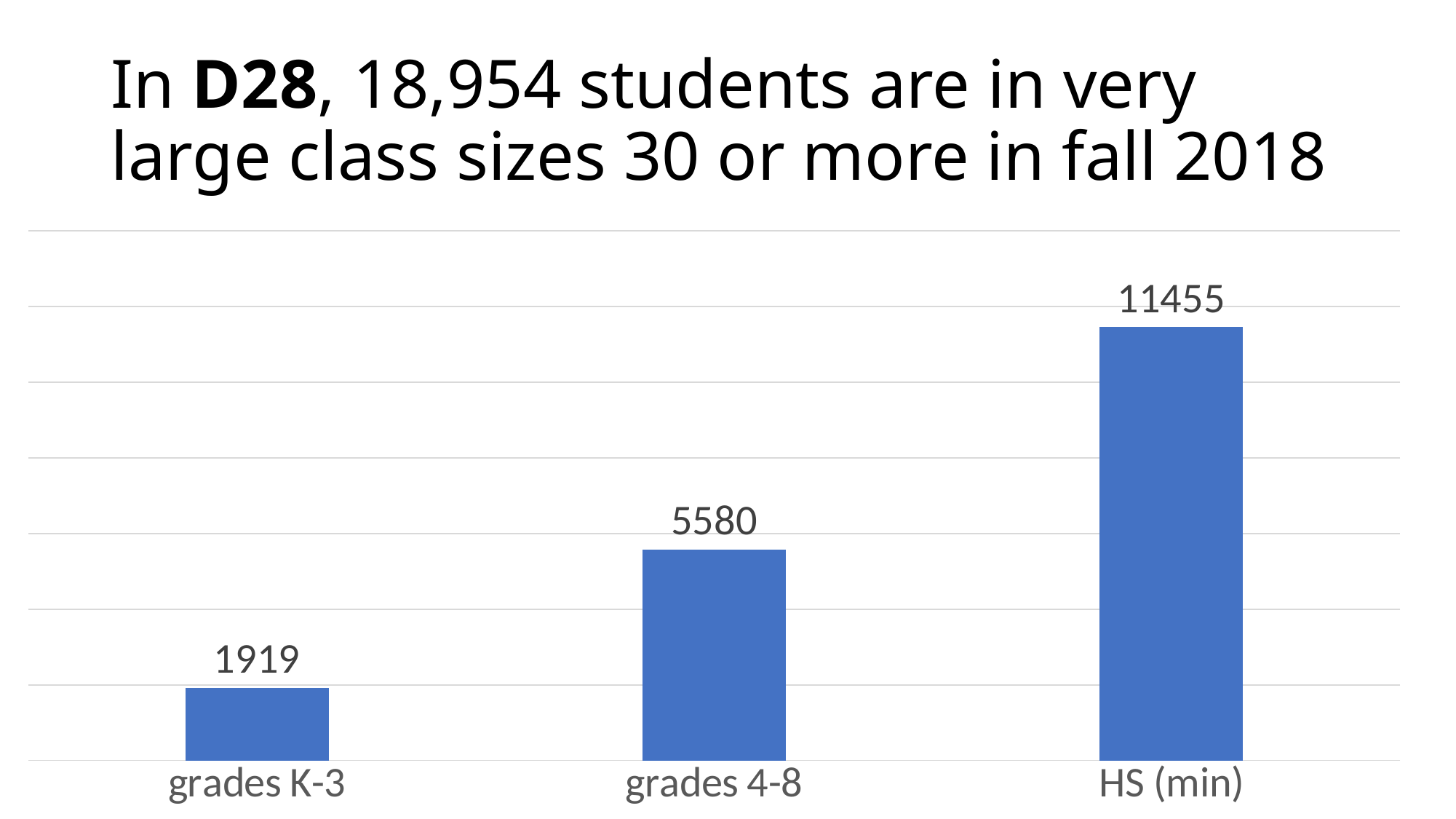
Which is larger, the value for grades 4-8 or the value for grades K-3? grades 4-8 What is the value for grades K-3? 1919 Which category has the highest value? HS (min) What is the difference between the values for HS (min) and grades 4-8? 5875 Do the values rise or fall from left to right across the categories? rise How many categories are shown in the chart? 3 What is the value for HS (min)? 11455 What kind of chart is shown on the slide? bar chart What is the value for grades 4-8? 5580 What is the difference between the values for HS (min) and grades K-3? 9536 Which category has the lowest value? grades K-3 What is the difference between the values for grades 4-8 and grades K-3? 3661